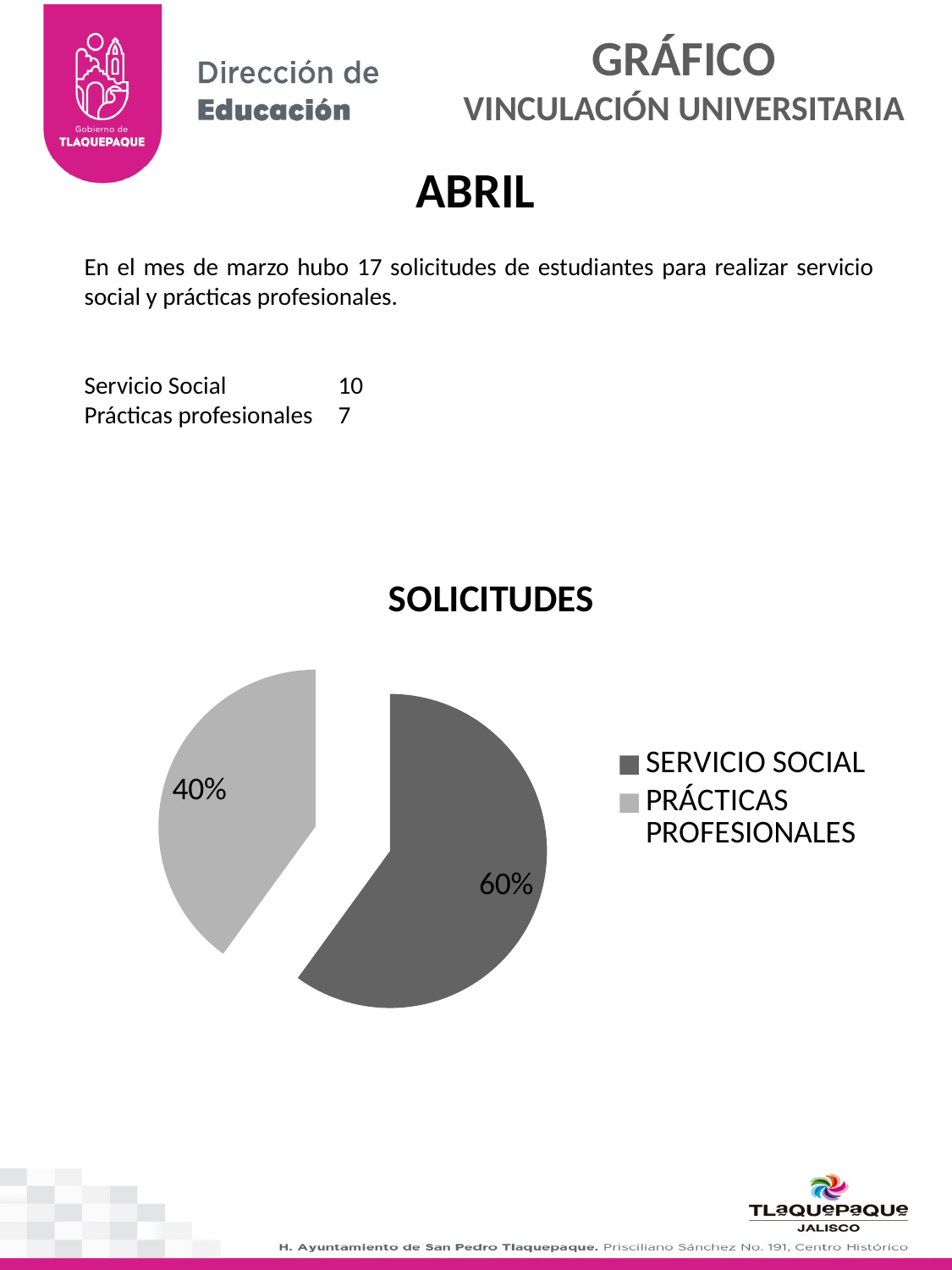
Which slice of the pie is the smallest? PRÁCTICAS PROFESIONALES What is the difference in percentage points between the SERVICIO SOCIAL and PRÁCTICAS PROFESIONALES slices? 20% Which legend entry is shown in the darker grey colour? SERVICIO SOCIAL Which is larger, the SERVICIO SOCIAL slice or the PRÁCTICAS PROFESIONALES slice? SERVICIO SOCIAL What percentage does the SERVICIO SOCIAL slice show? 60% What share of the pie does PRÁCTICAS PROFESIONALES represent? 40% How many entries does the legend list? 2 Which slice of the pie is the largest? SERVICIO SOCIAL What percentage does the PRÁCTICAS PROFESIONALES slice show? 40% What is the title of the chart? SOLICITUDES How many slices does the pie chart have? 2 What kind of chart is shown under the title SOLICITUDES? pie chart